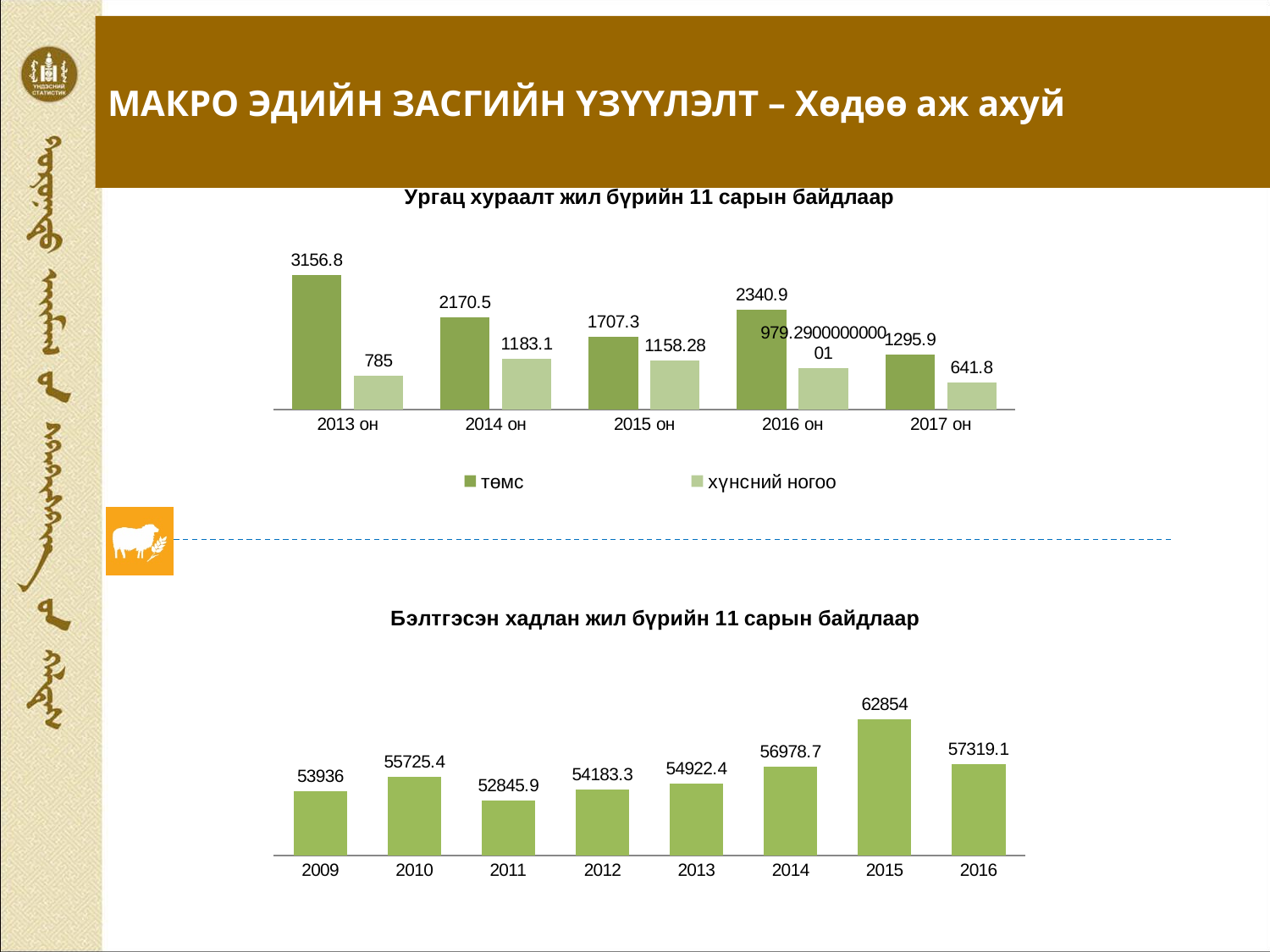
In the top chart (Ургац хураалт жил бүрийн 11 сарын байдлаар), which year has the lowest value for төмс? 2017 он In the top chart (Ургац хураалт жил бүрийн 11 сарын байдлаар), is the value for төмс larger in 2014 он or in 2016 он? 2016 он In the bottom chart (Бэлтгэсэн хадлан жил бүрийн 11 сарын байдлаар), which year has the lowest value? 2011 What kind of chart is the bottom chart (Бэлтгэсэн хадлан жил бүрийн 11 сарын байдлаар)? Bar chart In the bottom chart (Бэлтгэсэн хадлан жил бүрийн 11 сарын байдлаар), what is the difference between the values for 2015 and 2016? 5534.9 In the top chart (Ургац хураалт жил бүрийн 11 сарын байдлаар), what is the value for хүнсний ногоо in 2015 он? 1158.28 In the bottom chart (Бэлтгэсэн хадлан жил бүрийн 11 сарын байдлаар), how many years are shown? 8 In the bottom chart (Бэлтгэсэн хадлан жил бүрийн 11 сарын байдлаар), what is the value for 2015? 62854 In the top chart (Ургац хураалт жил бүрийн 11 сарын байдлаар), what is the difference between төмс and хүнсний ногоо in 2017 он? 654.1 In the top chart (Ургац хураалт жил бүрийн 11 сарын байдлаар), what is the value for төмс in 2013 он? 3156.8 In the top chart (Ургац хураалт жил бүрийн 11 сарын байдлаар), which year has the highest value for хүнсний ногоо? 2014 он In the top chart (Ургац хураалт жил бүрийн 11 сарын байдлаар), how many series does the legend list? 2